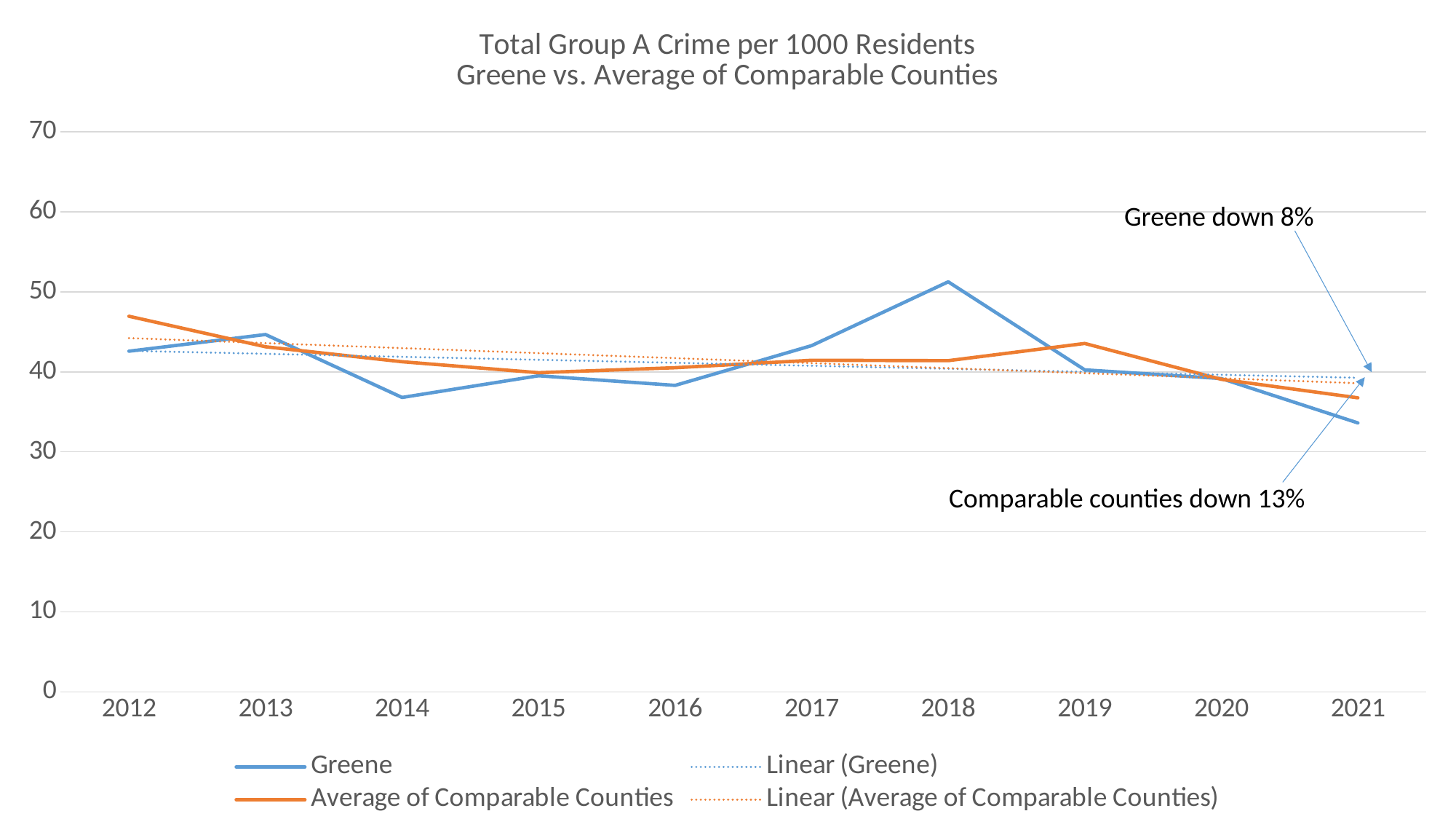
Does the Linear (Greene) trendline rise or fall from 2012 to 2021? fall In 2018, which series has the higher value, Greene or Average of Comparable Counties? Greene What kind of chart is shown on the slide? line chart In which year does the Greene line reach its highest value? 2018 Is the value for Greene in 2014 greater or less than 40? less How many entries does the legend list? 4 According to the annotation on the chart, by what percentage are comparable counties down? 13% In which year is the Average of Comparable Counties line at its highest? 2012 In which year does the Greene line reach its lowest value? 2021 How many years are plotted along the x axis? 10 Is the value for Average of Comparable Counties in 2012 greater or less than 40? greater In 2012, which series has the higher value, Greene or Average of Comparable Counties? Average of Comparable Counties